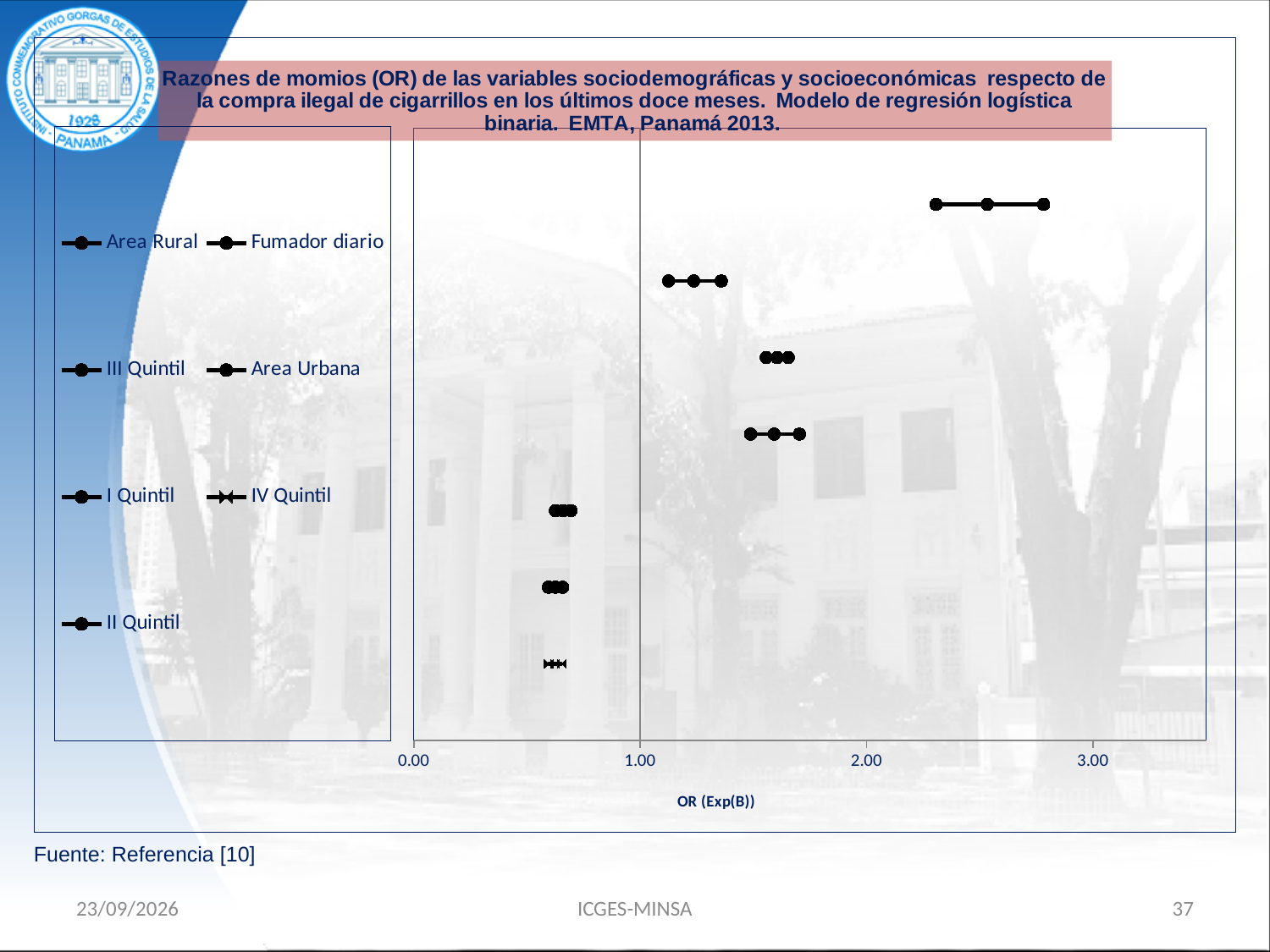
How many series are plotted entirely below 1.00 on the OR axis? 3 How many series does the chart legend list? 7 Which series in the legend is drawn with a different marker (an x-shaped marker) from the others? IV Quintil How many tick labels are shown on the horizontal axis? 4 Is the value for IV Quintil greater or less than 1.00? less How many series are plotted entirely above 2.00 on the OR axis? 1 Is the value for IV Quintil greater or less than 2.00? less What is the highest tick value shown on the horizontal axis? 3.00 What is the title of the horizontal axis of the chart? OR (Exp(B))